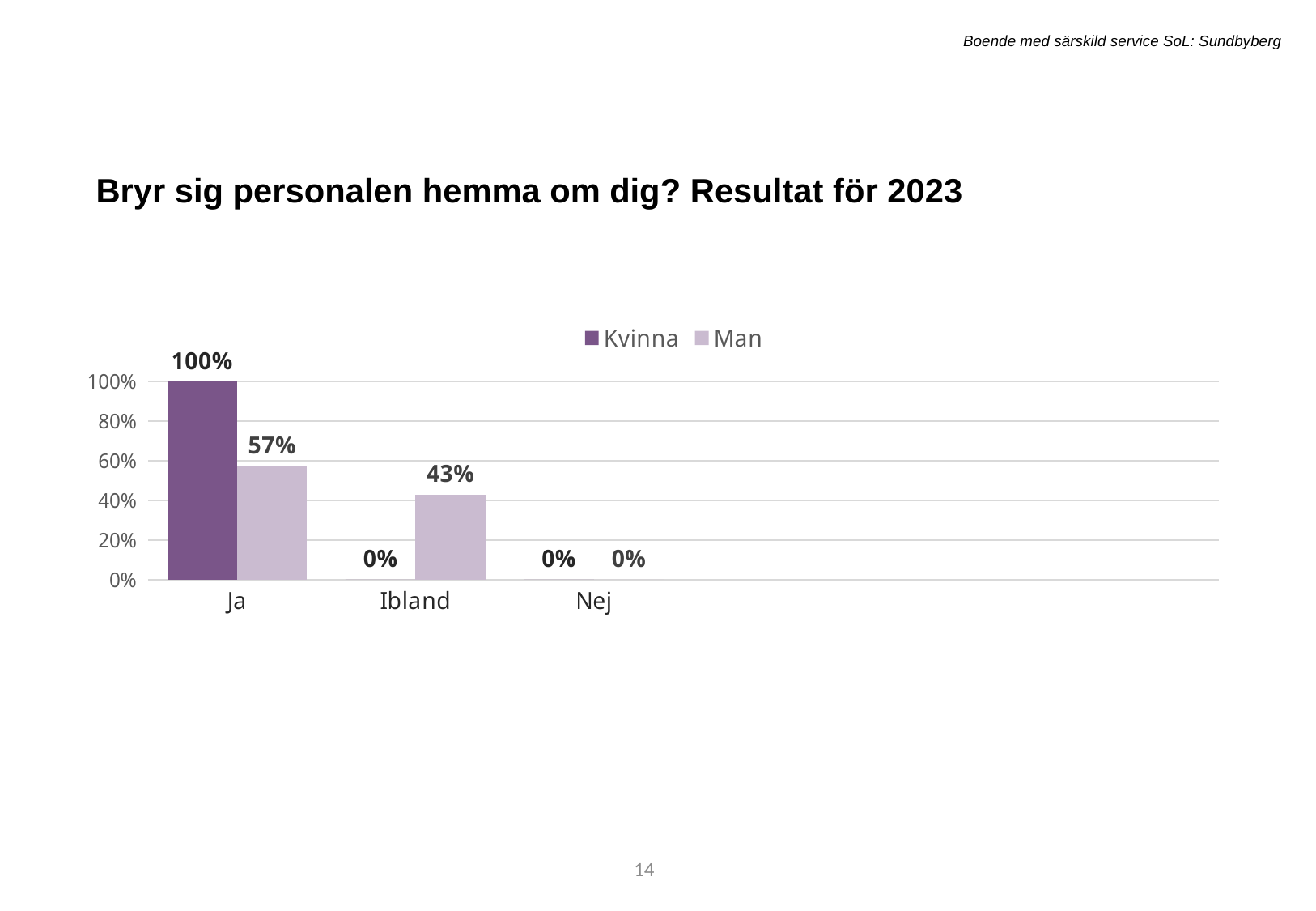
Which is larger for Man: the Ja value or the Ibland value? Ja What is the value for Man in the Ja category? 57% How many series does the legend list? 2 What kind of chart is shown on the slide? Bar chart How many categories are shown on the x axis? 3 What is the difference between the Kvinna and Man values in the Ja category? 43% What is the value for Man in the Ibland category? 43% What is the title of the chart? Bryr sig personalen hemma om dig? Resultat för 2023 What is the value for Kvinna in the Ja category? 100% What is the value for Kvinna in the Ibland category? 0% Which series is shown in the darker purple colour? Kvinna Which category has the highest value for Man? Ja